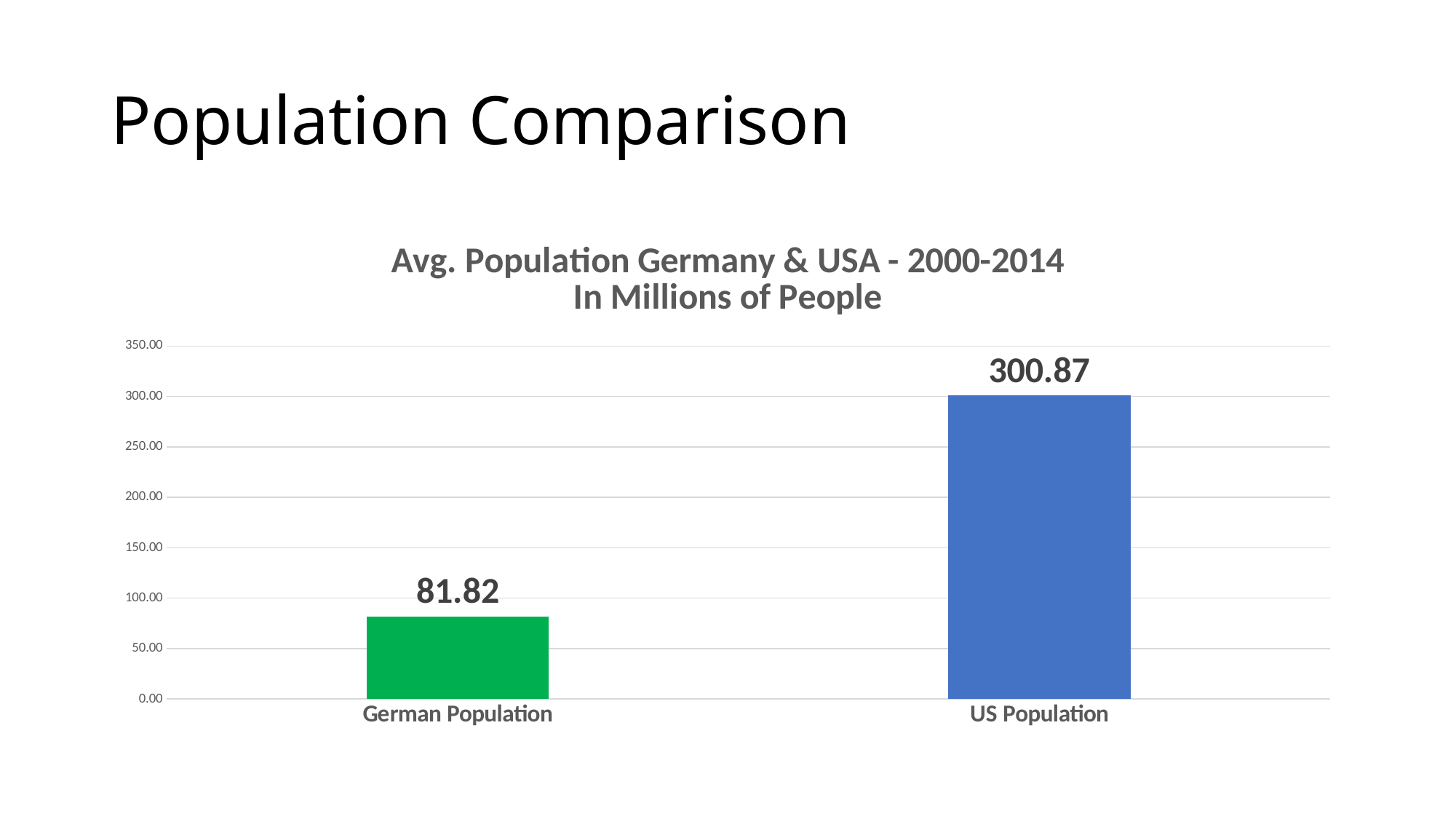
What is the value for German Population? 81.82 Is the value for US Population greater or less than 250.00? greater What is the difference between the US Population and German Population values? 219.05 What is the title of the chart? Avg. Population Germany & USA - 2000-2014 In Millions of People Is the value for German Population greater or less than 100.00? less How many categories are shown in the chart? 2 Which is larger, German Population or US Population? US Population What colour is the bar for German Population? green What kind of chart is shown on the slide? bar chart Which category has the highest value? US Population Which category has the lowest value? German Population What is the value for US Population? 300.87